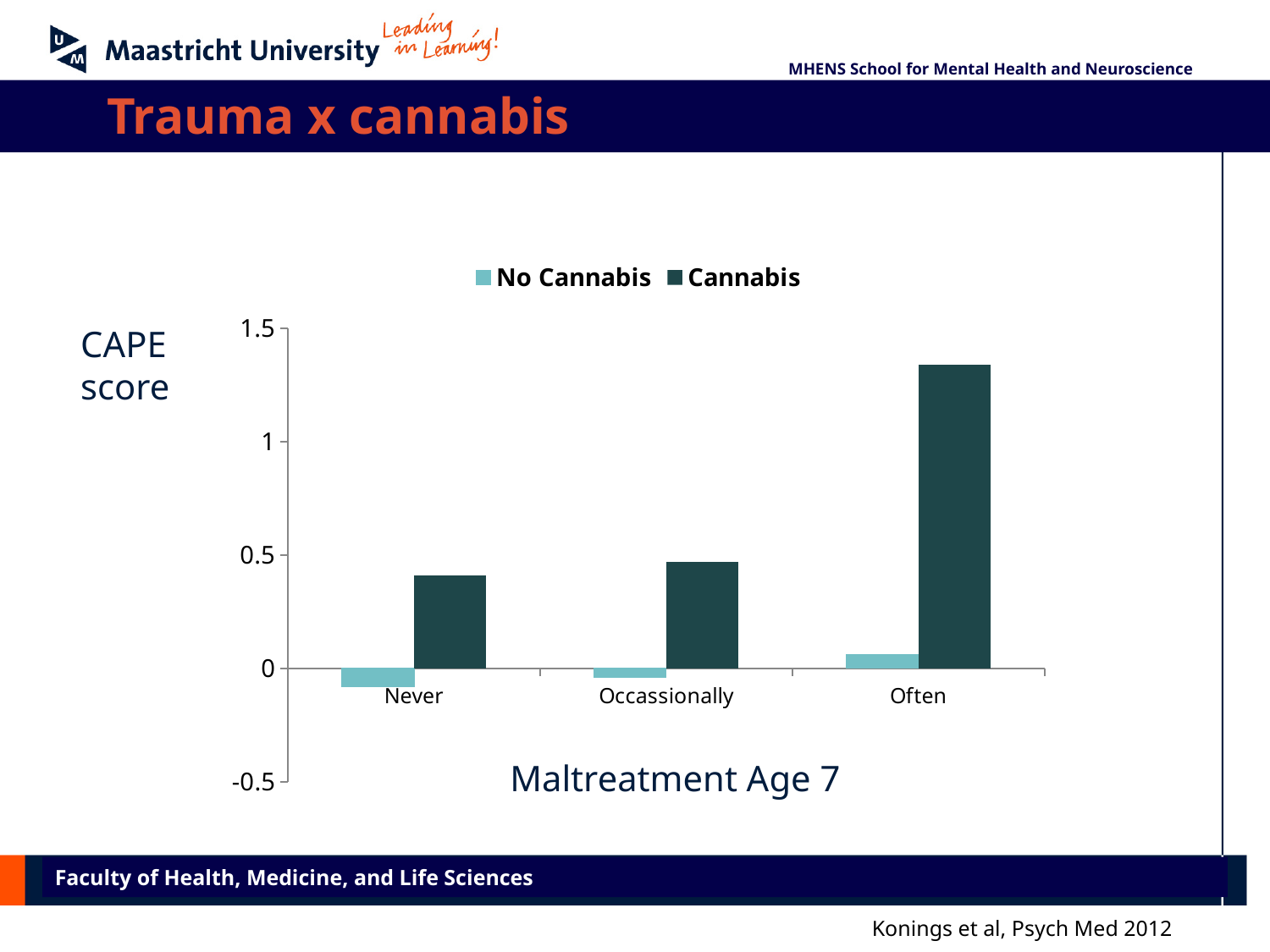
For the Cannabis series, which maltreatment category has the highest CAPE score? Often Is the No Cannabis value for Often greater or less than 0.5? less How many series does the legend list? 2 Is the Cannabis value for Often greater or less than 1? greater What are the two legend entries of the chart? No Cannabis, Cannabis How many maltreatment categories are shown on the x axis? 3 Is the Cannabis value for Never greater or less than 0.5? less What is the x-axis title of the chart? Maltreatment Age 7 What kind of chart is shown on the slide? bar chart For the Often category, which is larger: the Cannabis value or the No Cannabis value? Cannabis Do the Cannabis values rise or fall from Never to Often along the x axis? rise